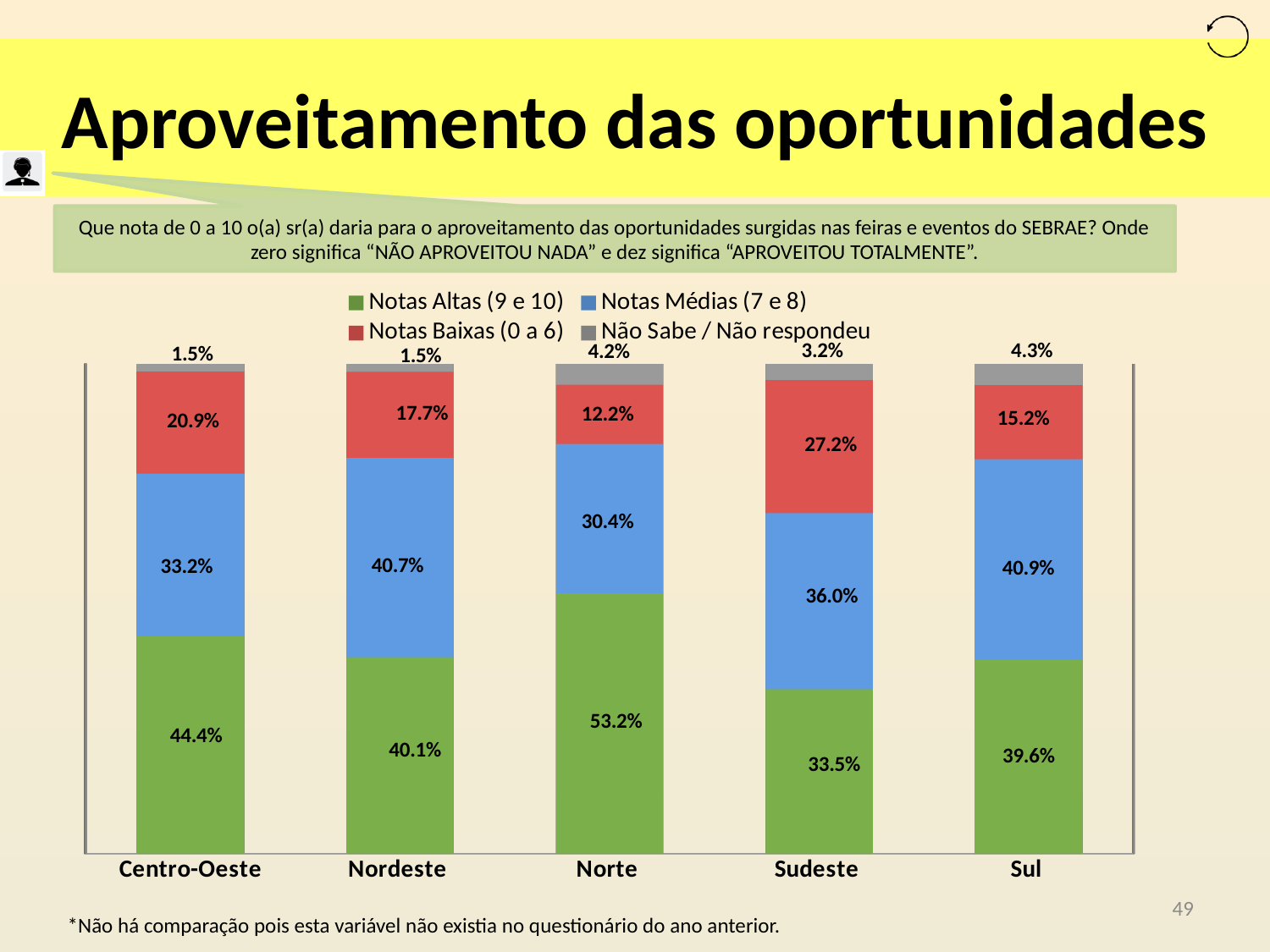
What is the value of Notas Baixas (0 a 6) for Sudeste? 27.2% What is the value of Não Sabe / Não respondeu for Centro-Oeste? 1.5% What kind of chart is shown on the slide? Stacked bar chart What is the value of Notas Médias (7 e 8) for Sul? 40.9% What is the value of Notas Altas (9 e 10) for Norte? 53.2% Which region has the lowest value for Notas Baixas (0 a 6)? Norte How many series does the legend list? 4 How many regions are shown on the x axis? 5 What is the difference between the Notas Altas (9 e 10) values for Norte and Sudeste? 19.7% Which colour represents Notas Baixas (0 a 6) in the chart? Red Which is larger: Notas Médias (7 e 8) for Nordeste or for Centro-Oeste? Nordeste Which region has the highest value for Notas Altas (9 e 10)? Norte